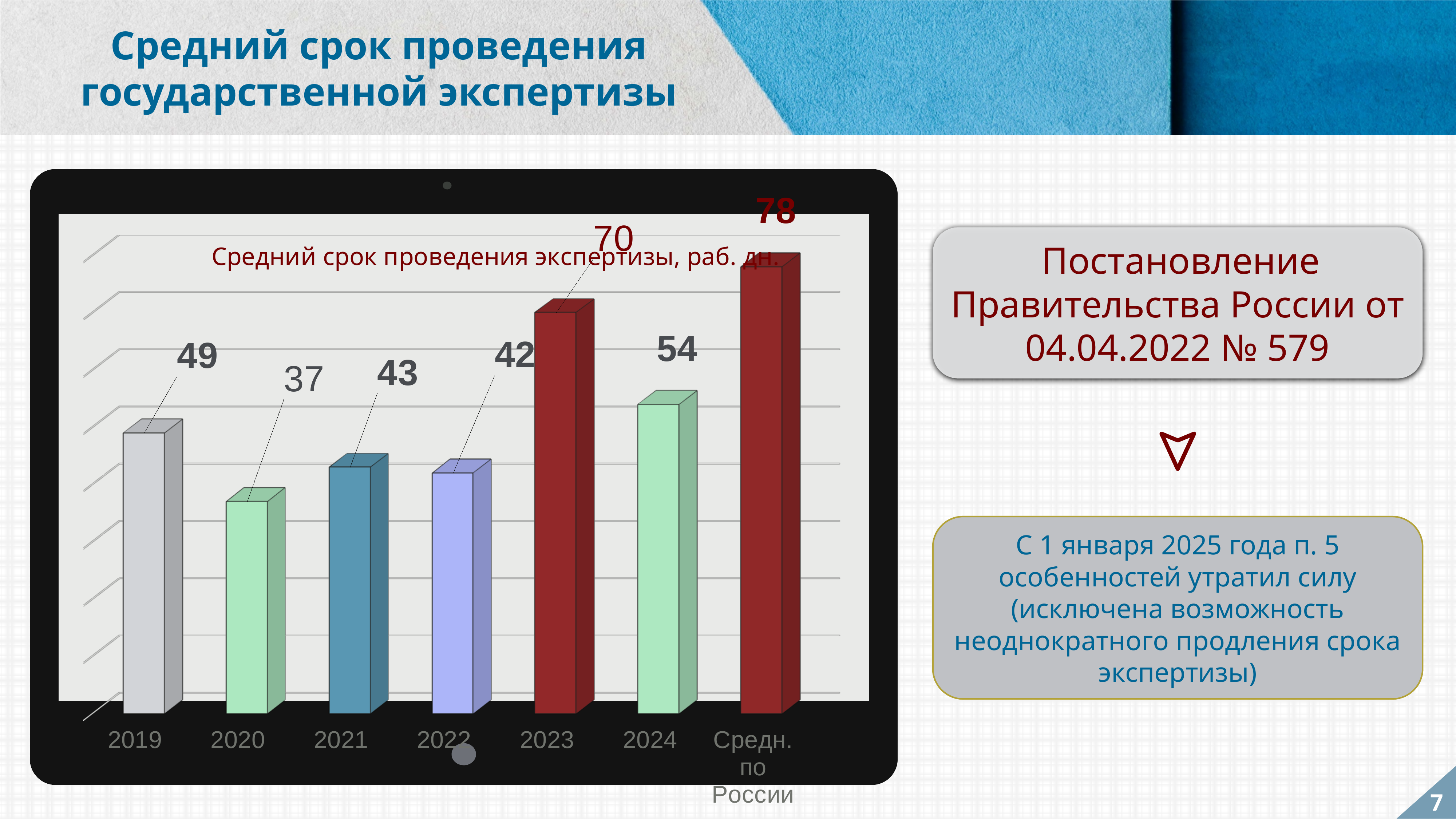
How many categories are shown on the x axis? 7 What is the title of the chart? Средний срок проведения экспертизы, раб. дн. Which is larger, the value for 2021 or the value for 2024? 2024 What is the value for 2019? 49 Which category has the lowest value? 2020 What kind of chart is shown on the slide? Bar chart Which category has the highest value? Средн. по России What is the value for 'Средн. по России'? 78 What is the value for 2024? 54 What is the value for 2023? 70 What is the difference between the values for 2023 and 2024? 16 What is the difference between the values for 2019 and 2020? 12